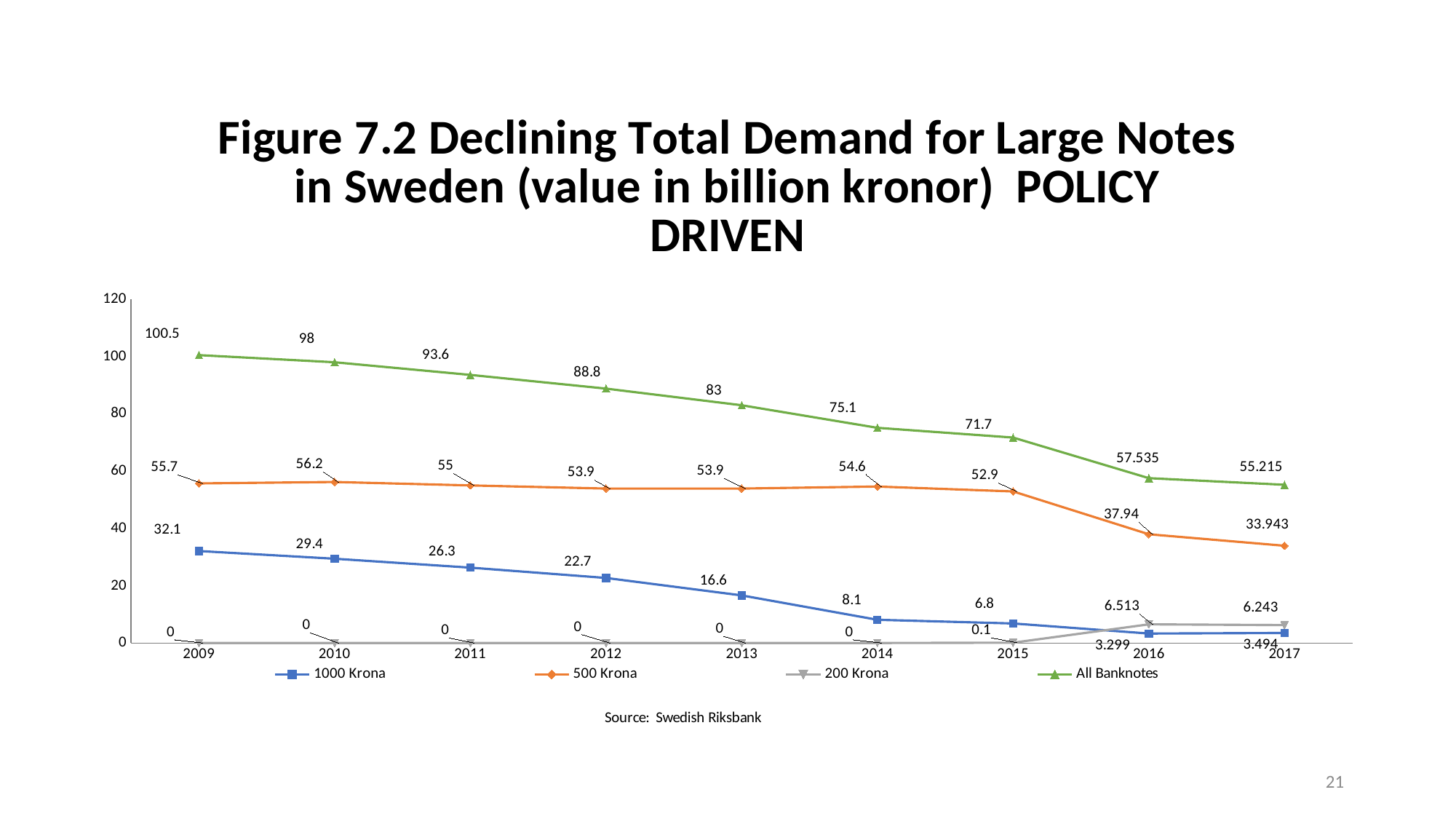
In which year is the 1000 Krona value highest? 2009 In which year is the All Banknotes value lowest? 2017 How many years are shown on the x axis? 9 Does the 1000 Krona series generally rise or fall from 2009 to 2017? Fall How many series does the legend list? 4 Which is larger in 2015: the 500 Krona value or the 1000 Krona value? 500 Krona What is the value for 200 Krona in 2016? 6.513 What kind of chart is shown on the slide? Line chart What is the difference between the All Banknotes values in 2009 and 2017? 45.285 What is the value for All Banknotes in 2009? 100.5 What is the value for 1000 Krona in 2013? 16.6 What is the value for 500 Krona in 2017? 33.943